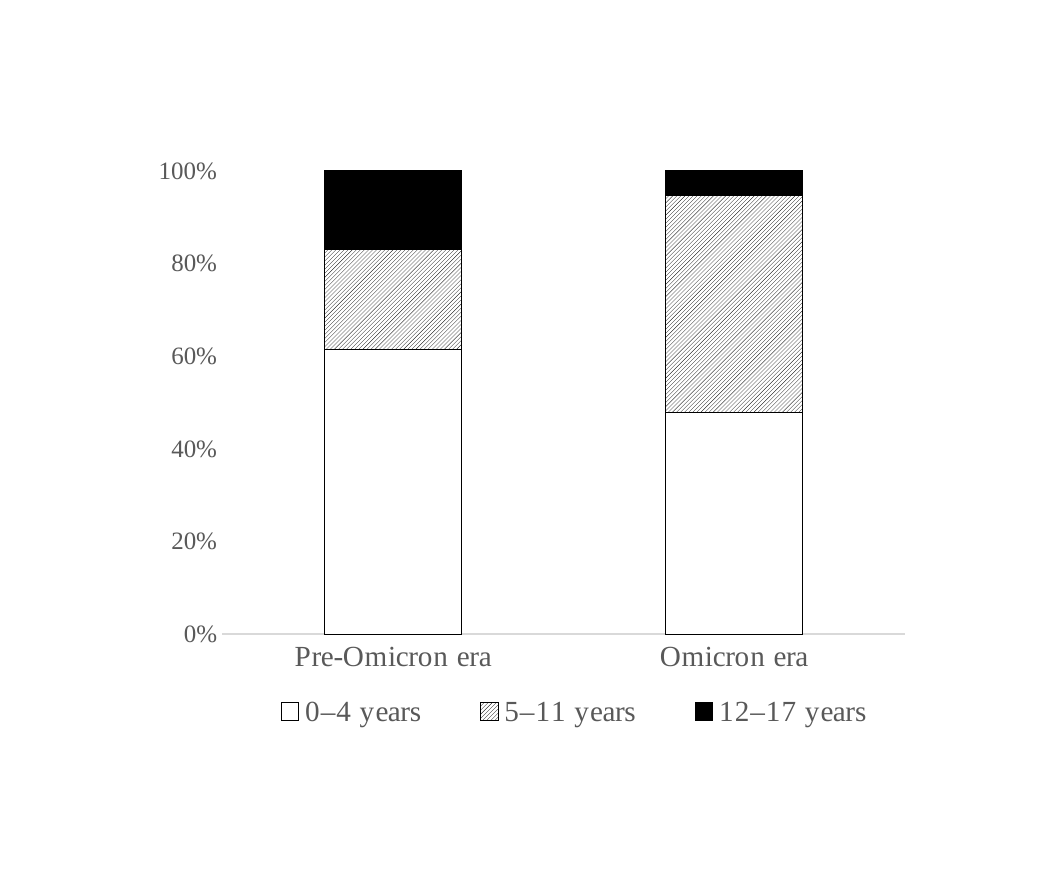
Which era has the larger share of 5–11 years? Omicron era What are the three age groups listed in the legend? 0–4 years, 5–11 years, 12–17 years Is the share of 0–4 years in the Pre-Omicron era greater or less than 40%? greater How many series does the legend list? 3 How many categories (eras) are shown on the x axis? 2 Which era has the larger share of 12–17 years? Pre-Omicron era What value does the top of each stacked bar reach on the y axis? 100% Is the share of 0–4 years in the Omicron era greater or less than 60%? less What kind of chart is shown on the slide? Stacked bar chart Is the share of 0–4 years in the Omicron era greater or less than 40%? greater Which age group has the smallest share in the Omicron era? 12–17 years Which era has the larger share of 0–4 years? Pre-Omicron era